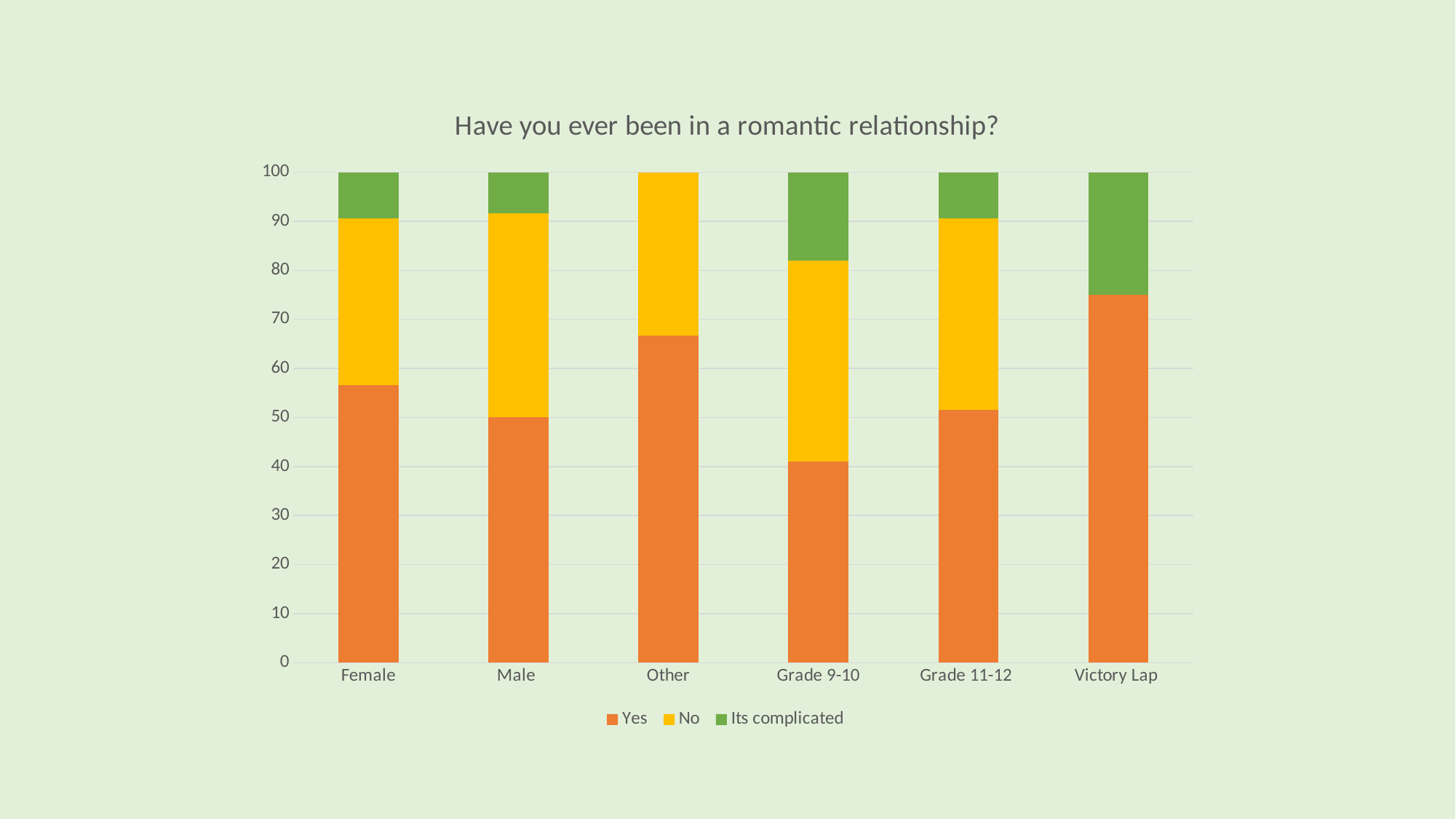
Is the "Yes" value for Grade 9-10 greater or less than 50? less Which category has the largest "Yes" segment? Victory Lap Which category has the largest "Its complicated" segment? Victory Lap How many categories are shown along the x axis? 6 Which has a larger "Yes" segment, Other or Male? Other Which category has the smallest "Yes" segment? Grade 9-10 Is the "Yes" value for Victory Lap greater or less than 70? greater How many series does the legend list? 3 What is the title of the chart? Have you ever been in a romantic relationship? Is the "Yes" value for Female greater or less than 50? greater What is the total height of the stacked bar for Female? 100 What kind of chart is shown on the slide? Stacked bar chart